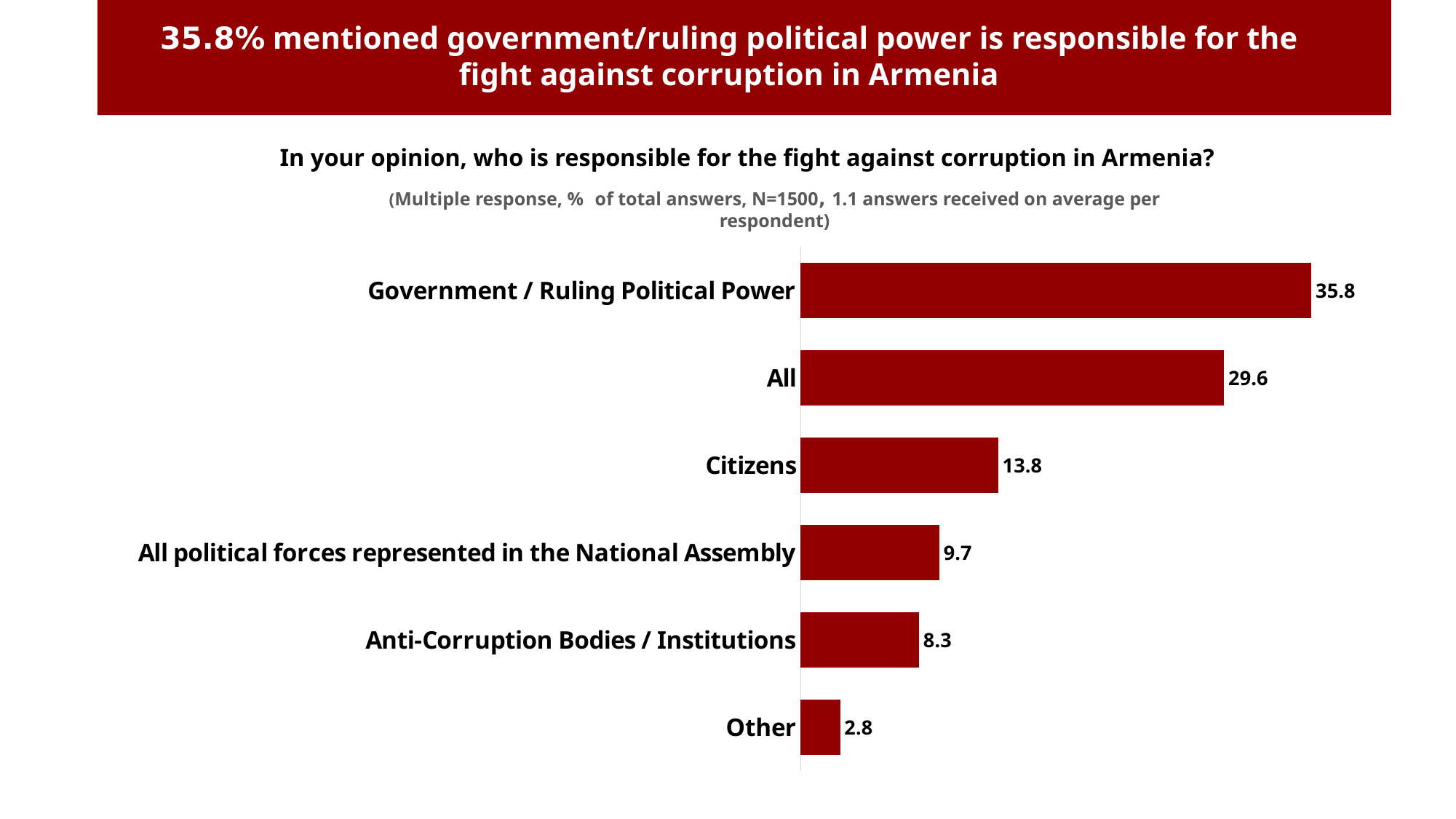
What value is shown for Citizens? 13.8 Which is larger, the value for All or the value for Citizens? All What is the sample size (N) stated in the chart subtitle? N=1500 Which category has the lowest value? Other What value is shown for All political forces represented in the National Assembly? 9.7 How many categories are shown in the chart? 6 What kind of chart is shown on the slide? Bar chart Which category has the highest value? Government / Ruling Political Power What is the chart's title? In your opinion, who is responsible for the fight against corruption in Armenia? What is the difference between the values for Citizens and Other? 11.0 What is the difference between the values for Government / Ruling Political Power and All? 6.2 What value is shown for Anti-Corruption Bodies / Institutions? 8.3